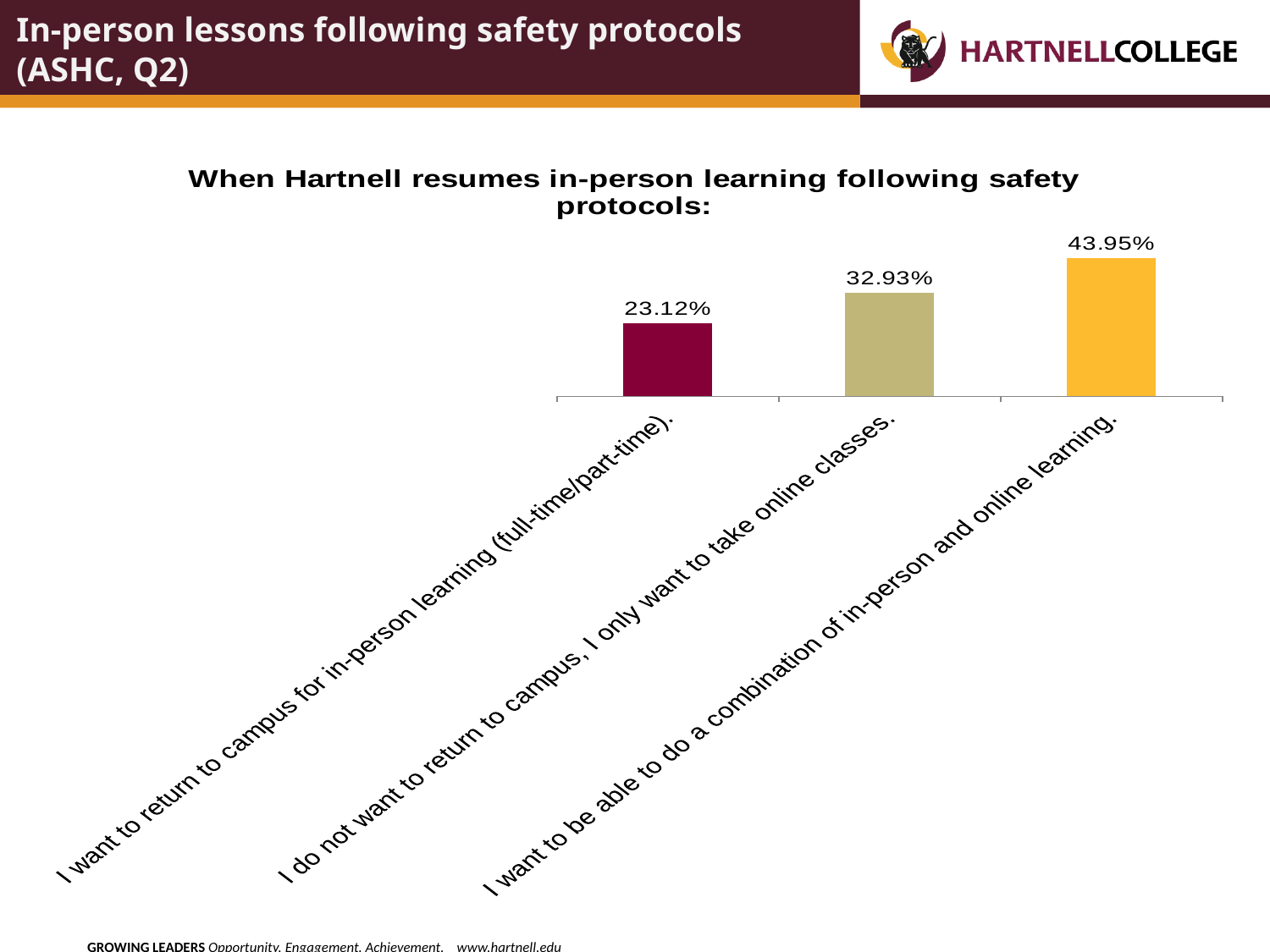
What is the difference in percentage points between the combination option and the in-person only option? 20.83 Which response option has the highest percentage? I want to be able to do a combination of in-person and online learning. Do the values rise or fall from left to right across the chart? Rise What percentage of respondents said they want to be able to do a combination of in-person and online learning? 43.95% Which is larger: the percentage for online-only classes or the percentage for returning to campus for in-person learning? Online-only classes How many response options are shown in the chart? 3 What percentage of respondents said they do not want to return to campus and only want to take online classes? 32.93% Which response option has the lowest percentage? I want to return to campus for in-person learning (full-time/part-time). What is the title of the chart? When Hartnell resumes in-person learning following safety protocols: What type of chart is shown on the slide? Bar chart What percentage of respondents said they want to return to campus for in-person learning (full-time/part-time)? 23.12% What is the difference in percentage points between the online-only option and the in-person only option? 9.81